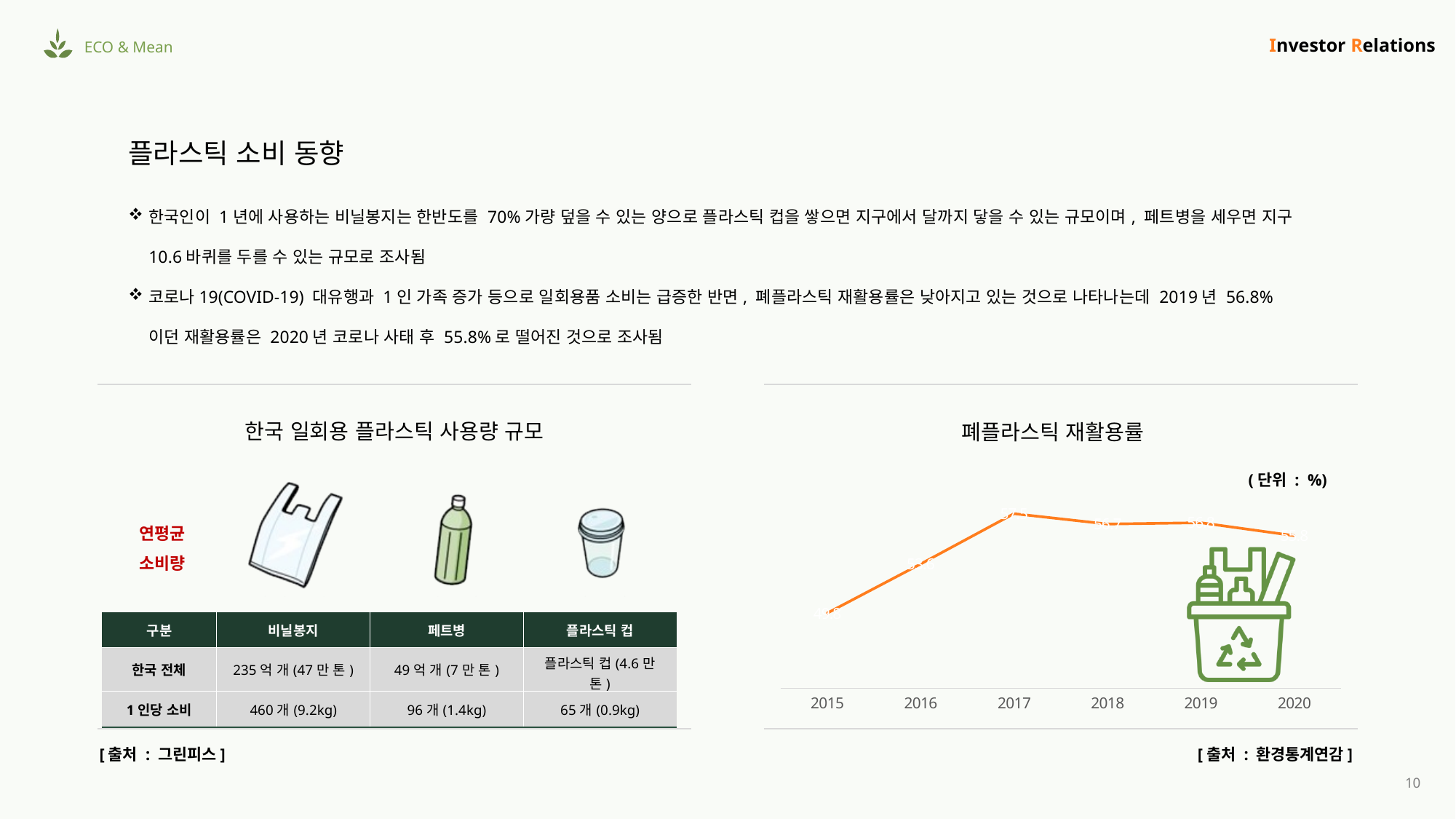
Which year has the highest value on the 폐플라스틱 재활용률 chart? 2017 On the 폐플라스틱 재활용률 chart, does the value rise or fall from 2015 to 2017? rise What is the first year shown on the x axis of the 폐플라스틱 재활용률 chart? 2015 What is the recycling rate for 2019 on the 폐플라스틱 재활용률 chart? 56.8% What kind of chart is the 폐플라스틱 재활용률 chart? line chart On the 폐플라스틱 재활용률 chart, is the value for 2016 or 2017 larger? 2017 On the 폐플라스틱 재활용률 chart, is the value for 2015 or 2018 larger? 2018 What is the recycling rate for 2020 on the 폐플라스틱 재활용률 chart? 55.8% What unit is indicated for the 폐플라스틱 재활용률 chart? % Which year has the lowest value on the 폐플라스틱 재활용률 chart? 2015 On the 폐플라스틱 재활용률 chart, does the value rise or fall from 2017 to 2020? fall How many years are plotted on the 폐플라스틱 재활용률 chart? 6